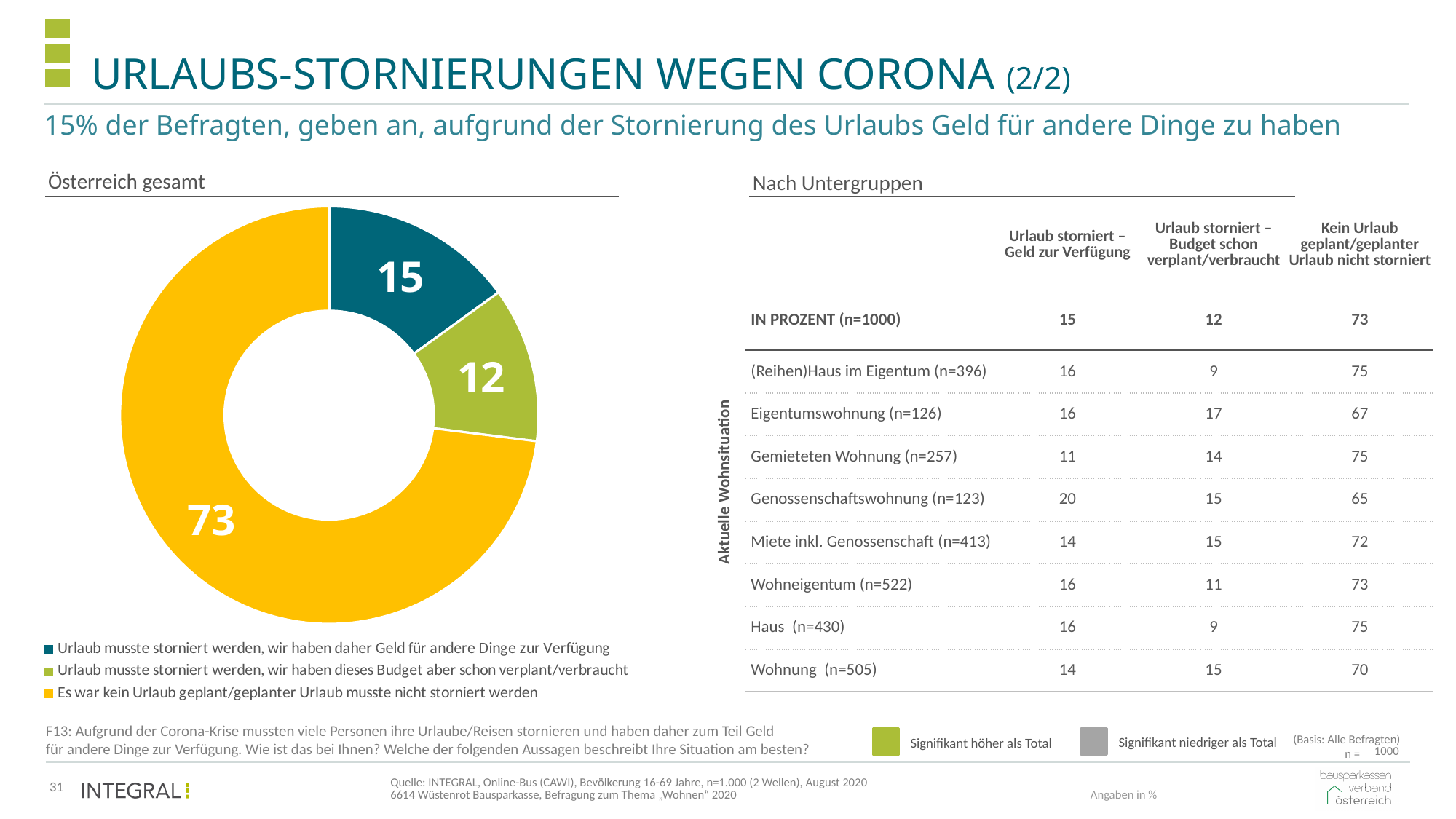
In the "Österreich gesamt" chart, what value is shown for "Urlaub musste storniert werden, wir haben daher Geld für andere Dinge zur Verfügung"? 15 In the "Österreich gesamt" chart, which is larger: the segment for "Geld für andere Dinge zur Verfügung" or the segment for "Budget schon verplant/verbraucht"? Geld für andere Dinge zur Verfügung (15) In the "Österreich gesamt" chart, what colour is the segment labelled 73? Yellow Which segment of the "Österreich gesamt" chart is the smallest? Urlaub musste storniert werden, wir haben dieses Budget aber schon verplant/verbraucht How many entries does the legend of the "Österreich gesamt" chart list? 3 How many segments does the "Österreich gesamt" chart have? 3 What type of chart is shown under "Österreich gesamt"? Pie chart (donut) In the "Österreich gesamt" chart, what is the difference between the largest segment (73) and the segment with value 15? 58 In the "Österreich gesamt" chart, what value is shown for the segment "Es war kein Urlaub geplant/geplanter Urlaub musste nicht storniert werden"? 73 In the "Österreich gesamt" chart, what value is shown for "Urlaub musste storniert werden, wir haben dieses Budget aber schon verplant/verbraucht"? 12 What is the total of the three segment values in the "Österreich gesamt" chart? 100 Which segment of the "Österreich gesamt" chart is the largest? Es war kein Urlaub geplant/geplanter Urlaub musste nicht storniert werden